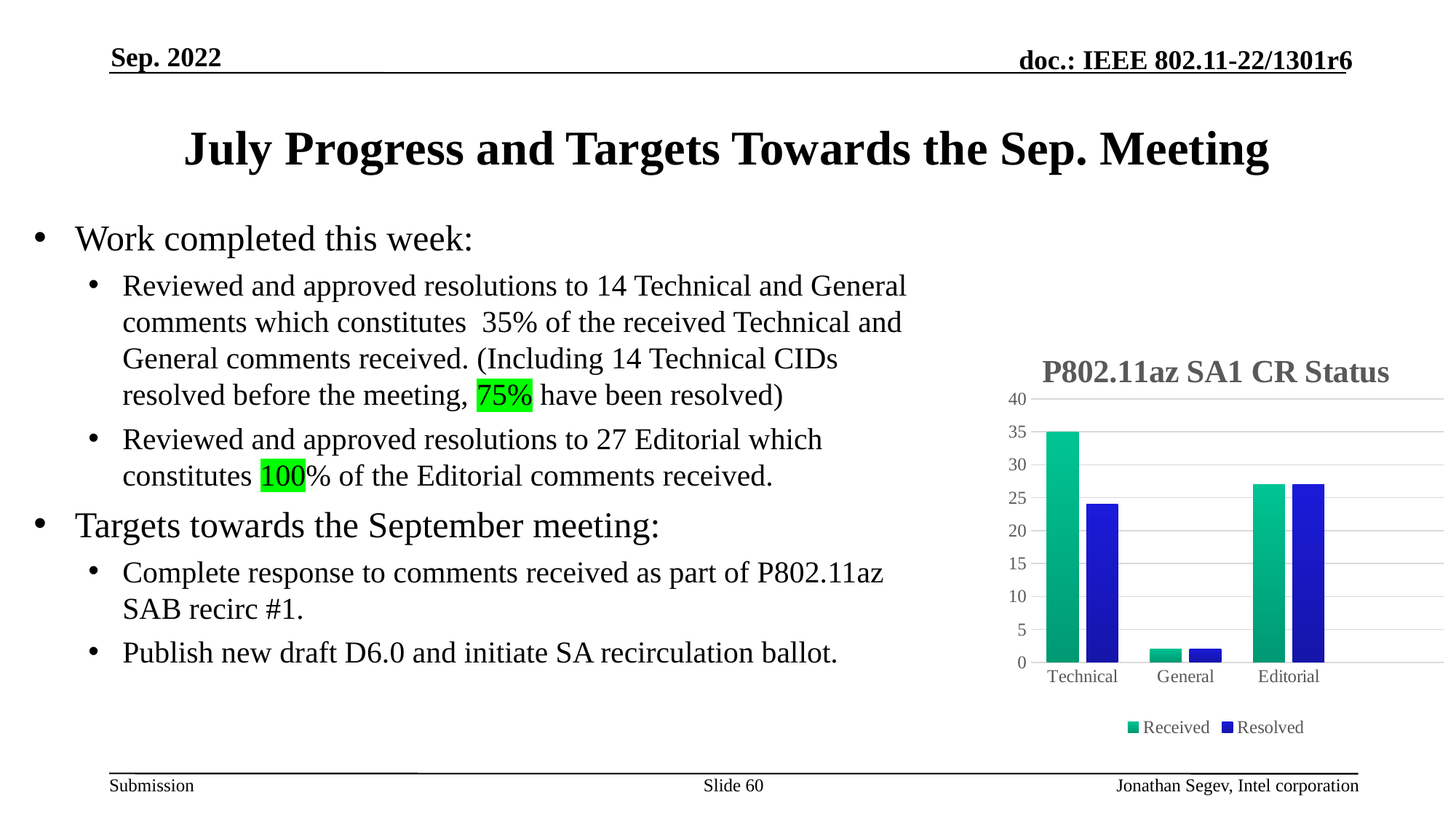
Which category has the lowest Received value? General How many series does the chart legend list? 2 Which legend entry is shown in dark blue? Resolved What is the title of the chart on the slide? P802.11az SA1 CR Status How many categories are shown on the x axis of the chart? 3 What kind of chart is shown on the slide? bar chart Which category has the highest Received value? Technical Is the Resolved value for Technical greater or less than 20? greater Is the Resolved value for Editorial greater or less than 30? less Is the Received value for Technical greater or less than 30? greater For the Technical category, which is larger: Received or Resolved? Received